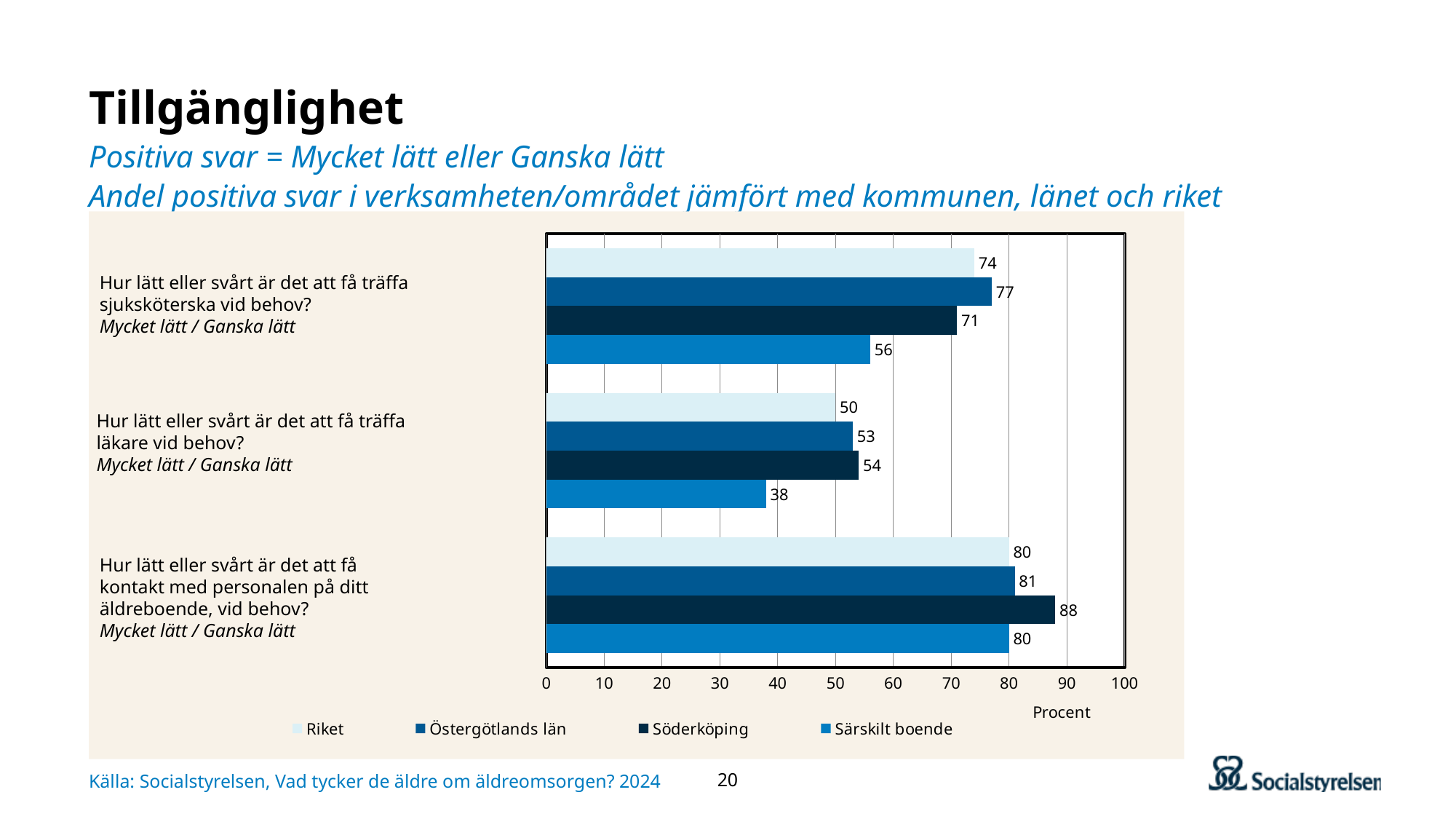
What is the value for Söderköping for the question about getting in contact with staff at the care home (kontakt med personalen)? 88 What is the value for Särskilt boende for the question about meeting a nurse (sjuksköterska) when needed? 56 What kind of chart is shown on the slide? bar chart How many series does the legend list? 4 What is the difference between Östergötlands län and Särskilt boende for the question about meeting a nurse (sjuksköterska)? 21 Which series has the highest value for the question about meeting a doctor (läkare) when needed? Söderköping Which series has the lowest value for the question about meeting a nurse (sjuksköterska) when needed? Särskilt boende Which is larger for the question about meeting a doctor (läkare): Östergötlands län or Särskilt boende? Östergötlands län How many questions (categories) are shown on the chart? 3 Is the value for Särskilt boende for the question about meeting a doctor (läkare) greater or less than 40? less What is the unit label shown below the x axis? Procent What is the value for Riket for the question about meeting a doctor (läkare) when needed? 50